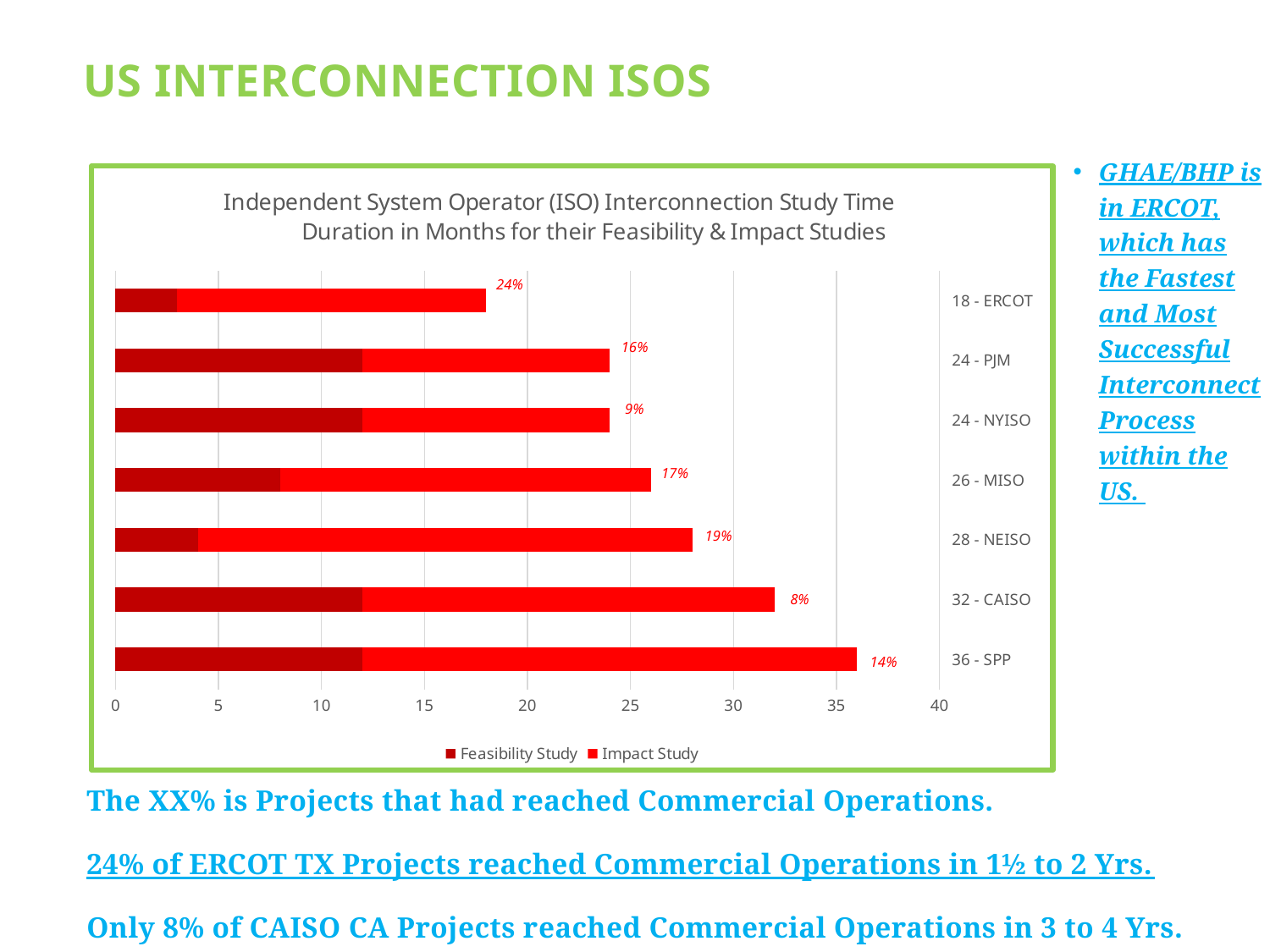
Which ISO has the shortest total study duration? ERCOT What percentage label is shown next to the ERCOT bar? 24% How many series does the chart legend list? 2 What is the total study duration in months for SPP? 36 What are the two series named in the chart legend? Feasibility Study and Impact Study How many ISOs (categories) are plotted in the chart? 7 Is the Feasibility Study value for PJM greater or less than 10? greater What kind of chart is shown on the slide? bar chart Which ISO has the longest total study duration? SPP What percentage label is shown next to the CAISO bar? 8% How many months longer is the total study duration for SPP than for ERCOT? 18 Which has the higher percentage label, NEISO or MISO? NEISO